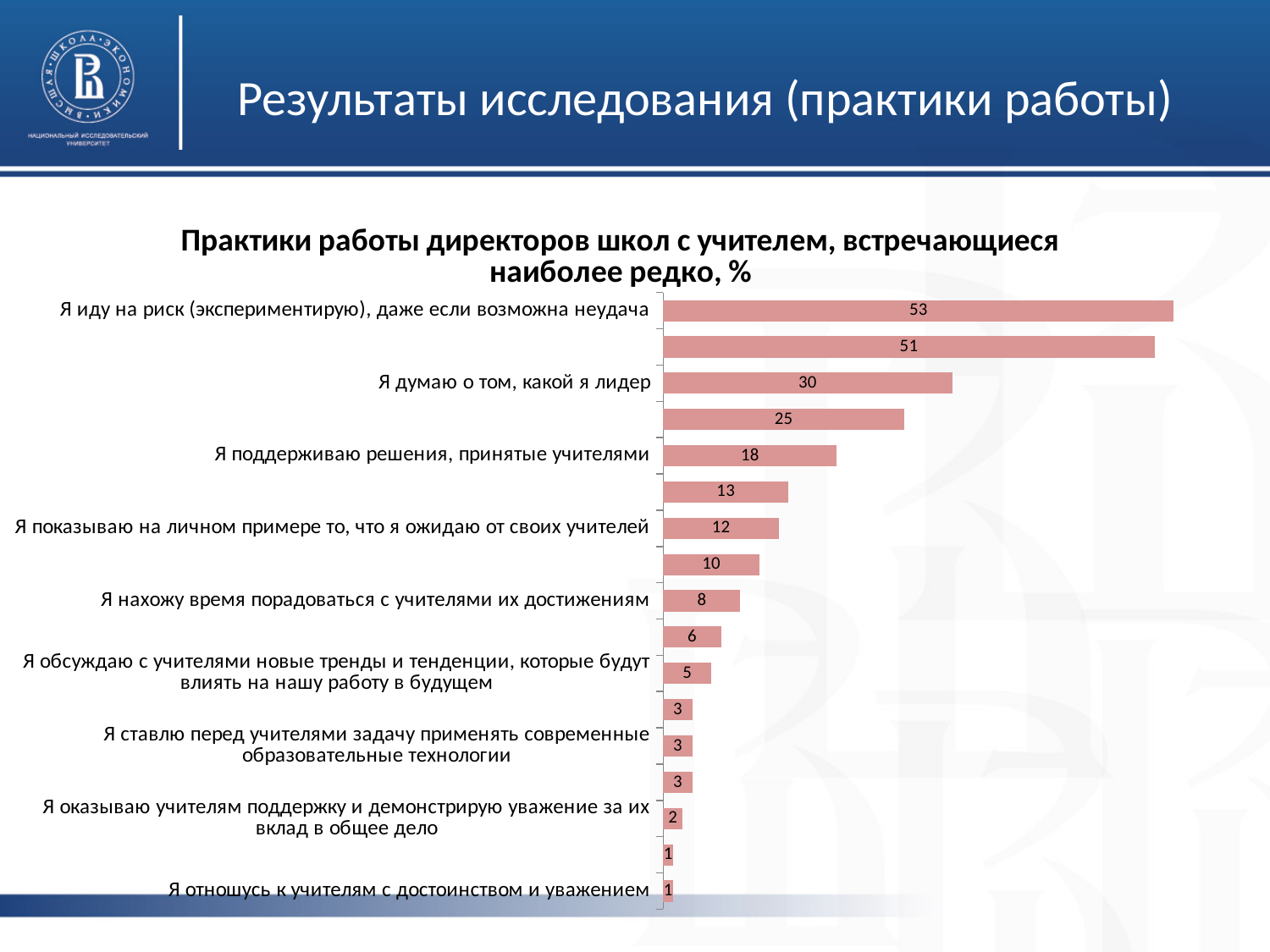
What is the value for "Я поддерживаю решения, принятые учителями"? 18 What is the value for "Я показываю на личном примере то, что я ожидаю от своих учителей"? 12 Which category has the highest value? Я иду на риск (экспериментирую), даже если возможна неудача What is the value for "Я думаю о том, какой я лидер"? 30 What is the value for "Я иду на риск (экспериментирую), даже если возможна неудача"? 53 What is the value for "Я нахожу время порадоваться с учителями их достижениям"? 8 What is the difference between the values for "Я иду на риск (экспериментирую), даже если возможна неудача" and "Я думаю о том, какой я лидер"? 23 How many bars are plotted in the chart? 17 What type of chart is shown on the slide? bar chart What is the title of the chart? Практики работы директоров школ с учителем, встречающиеся наиболее редко, % What is the value for "Я отношусь к учителям с достоинством и уважением"? 1 Which is larger: the value for "Я поддерживаю решения, принятые учителями" or for "Я нахожу время порадоваться с учителями их достижениям"? Я поддерживаю решения, принятые учителями